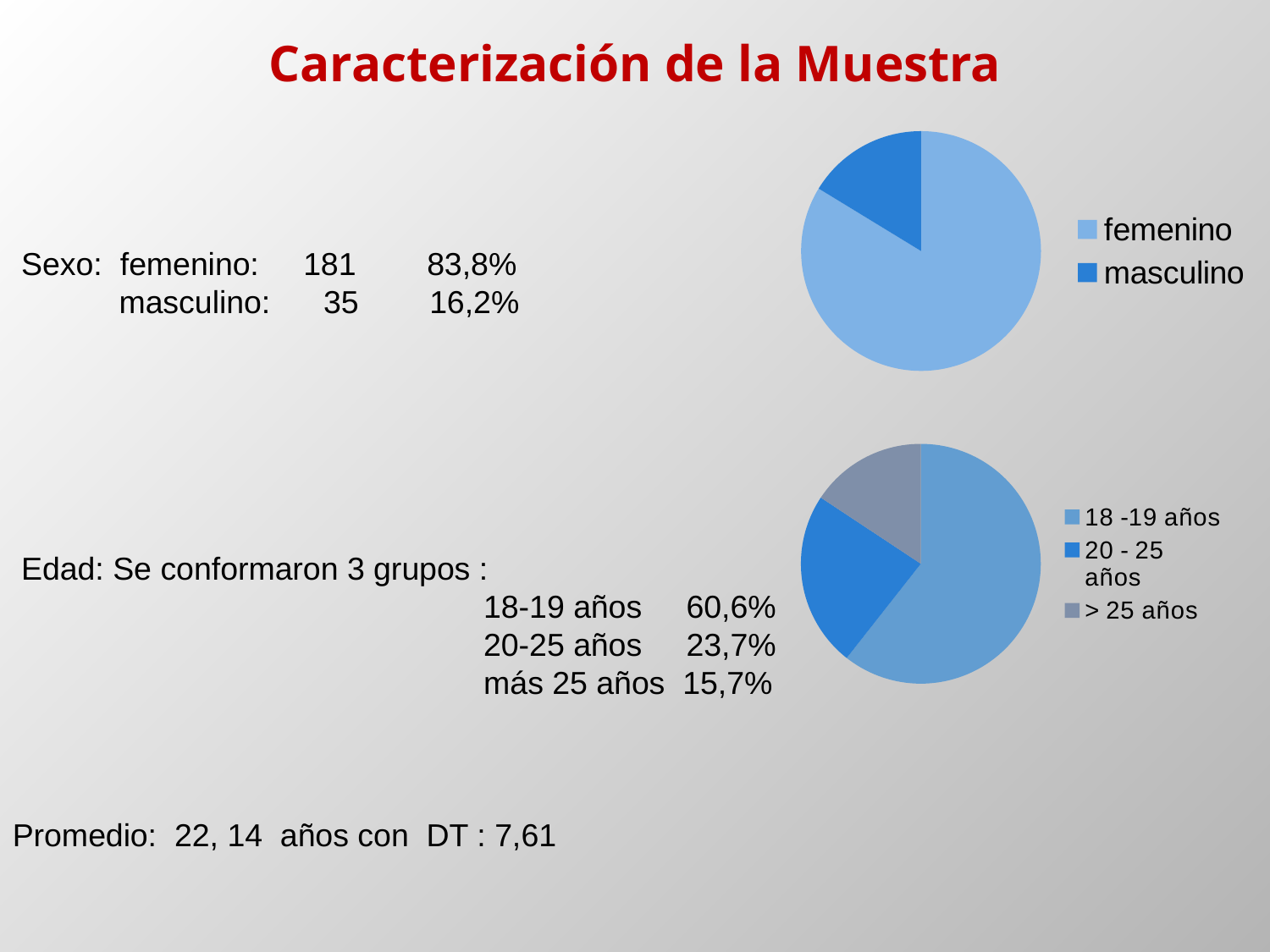
In the bottom pie chart, which age group has the smallest slice? > 25 años In the top pie chart, which category has the largest slice? femenino How many series does the legend of the top pie chart list? 2 What kind of chart is the bottom chart on the slide? pie chart What colour is the masculino slice in the top pie chart? dark blue How many series does the legend of the bottom pie chart list? 3 What kind of chart is the top chart on the slide? pie chart In the bottom pie chart, which slice is larger: 20 - 25 años or > 25 años? 20 - 25 años According to the slide, what share of the top pie chart does the femenino slice represent? 83,8% In the bottom pie chart, which age group has the largest slice? 18 -19 años According to the slide, what share of the bottom pie chart does the 20-25 años slice represent? 23,7% In the top pie chart, which category has the smallest slice? masculino